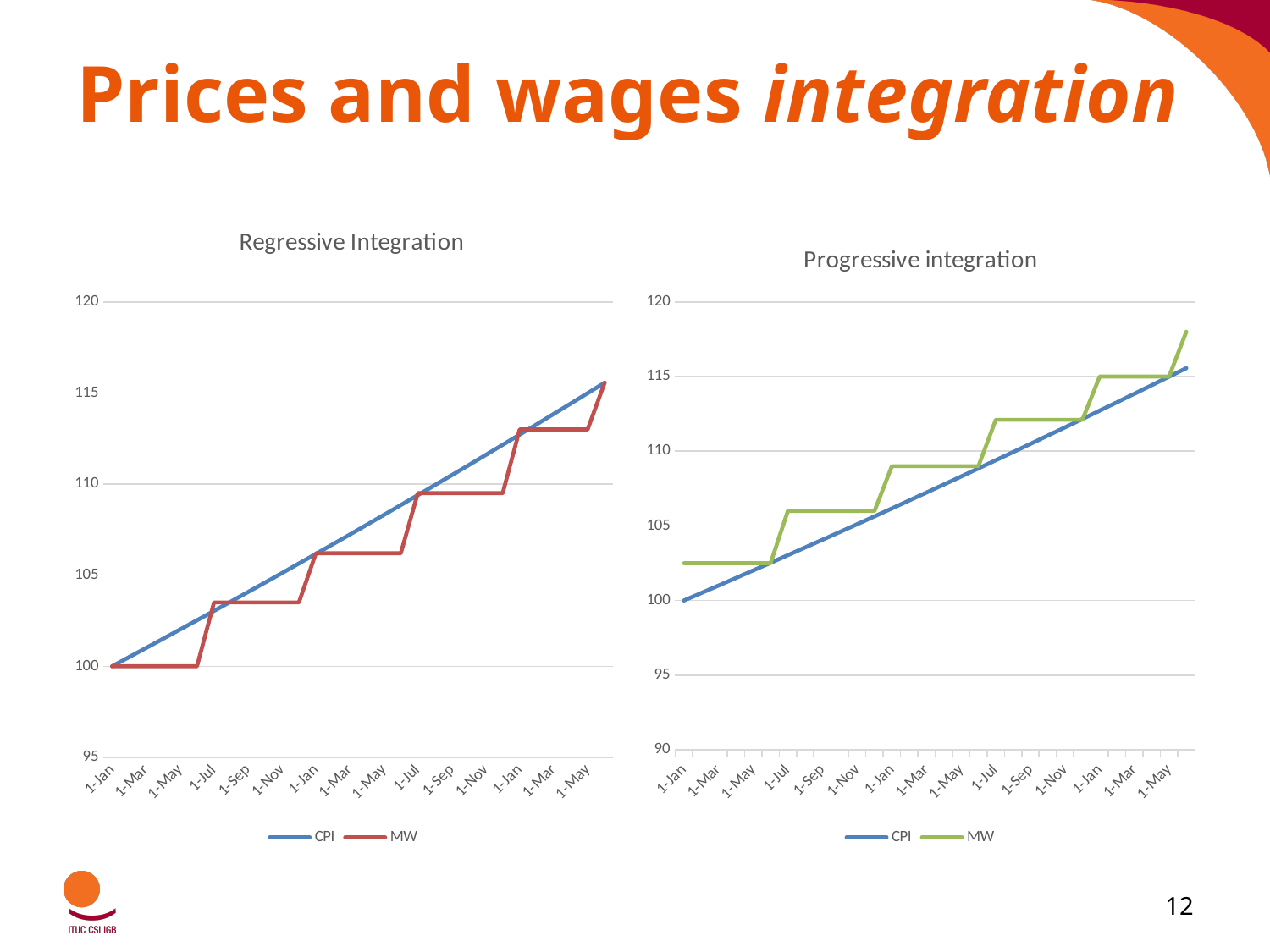
In the Regressive Integration chart, what is the value of MW at the first 1-Jan? 100 In the Regressive Integration chart, which series is higher at the second 1-Mar, CPI or MW? CPI In the Progressive integration chart, is the value of MW at the first 1-Sep greater or less than 105? greater In the Regressive Integration chart, what is the value of CPI at the first 1-Jan? 100 In the Progressive integration chart, what is the value of CPI at the first 1-Jan? 100 In the Progressive integration chart, which series is higher at the second 1-Jul, CPI or MW? MW What colour is the MW line in the Progressive integration chart? green How many series does the legend of the Progressive integration chart list? 2 In the Progressive integration chart, does the CPI series rise or fall over time? rise In the Regressive Integration chart, is the value of MW at the first 1-May greater or less than 105? less What kind of chart is the Regressive Integration chart? line chart